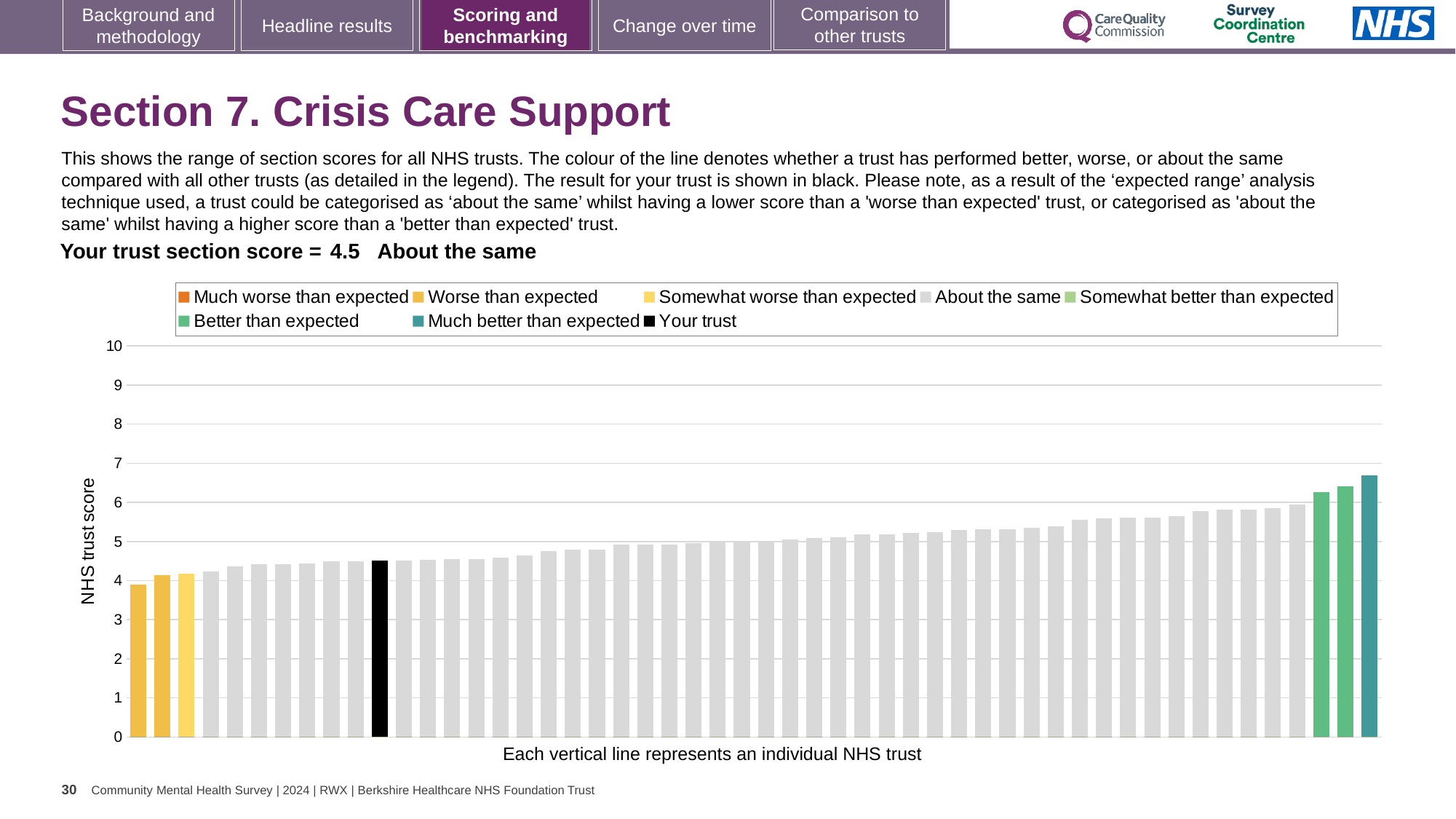
Which legend category does the tallest bar on the chart belong to? Much better than expected How many bars are coloured as 'Much better than expected'? 1 What is the label on the vertical axis of the chart? NHS trust score How many entries does the chart legend list? 8 How many bars are coloured as 'Better than expected'? 2 What kind of chart is shown on the slide? bar chart Is the value of the black 'Your trust' bar greater or less than 4? greater What is the section score for your trust shown on the slide? 4.5 Is the value of the tallest bar (the 'Much better than expected' bar) greater or less than 6? greater Do the bar values rise or fall from left to right along the x axis? rise Is the black 'Your trust' bar taller or shorter than the green 'Better than expected' bars? shorter Is the value of the black 'Your trust' bar greater or less than 5? less